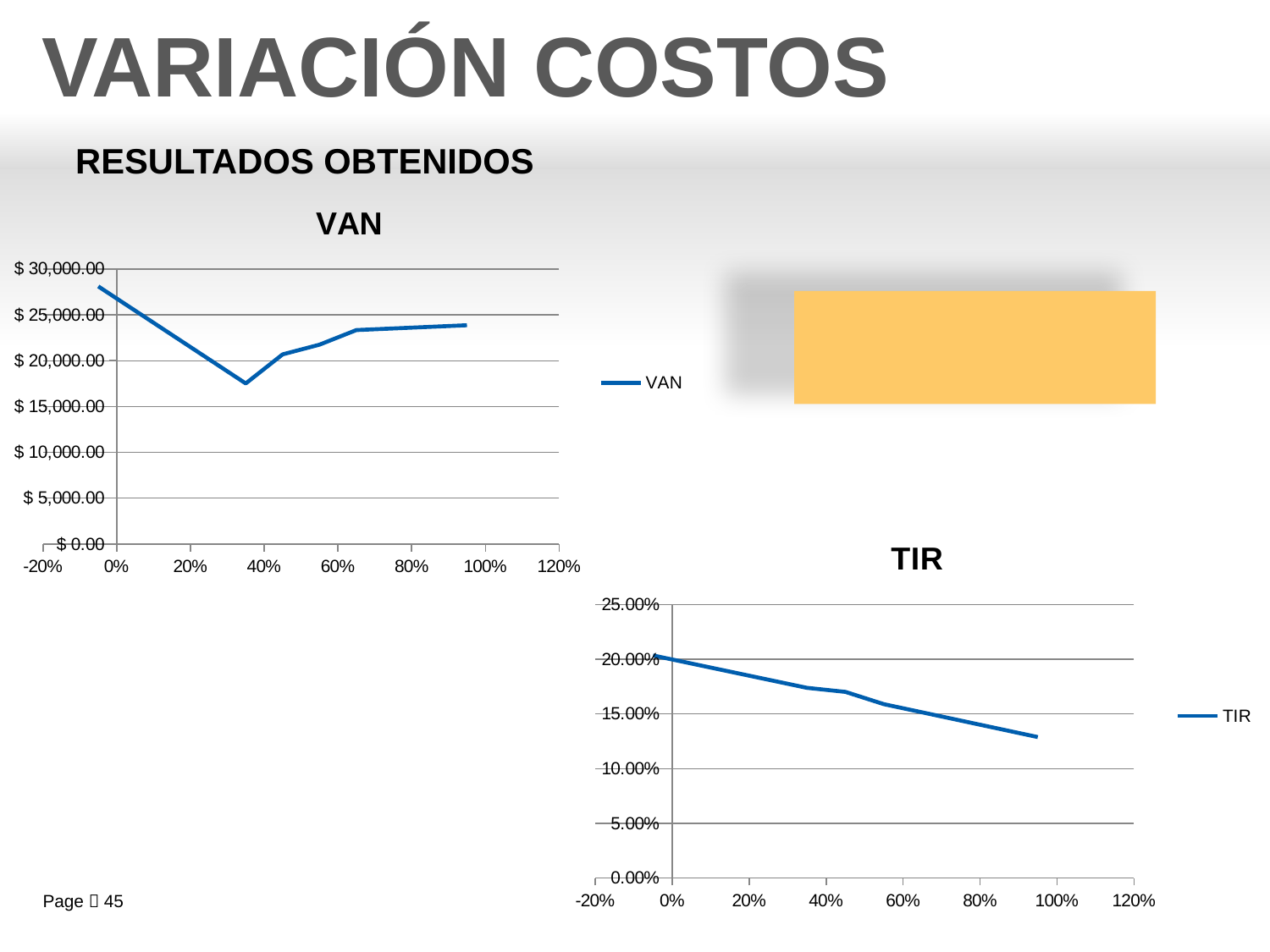
In the TIR chart, is the value at the leftmost point greater or less than 15.00%? greater What kind of chart is the TIR chart? line chart In the VAN chart, is the lowest value on the line greater or less than $20,000.00? less In the TIR chart, is the value at the rightmost point greater or less than 15.00%? less In the VAN chart, is the highest value at the left end or the right end of the line? left end In the TIR chart, do the values rise or fall as the x axis increases? fall What is the title of the chart on the right side of the slide? TIR How many series does the legend of the VAN chart list? 1 In the TIR chart, which is larger, the value at the leftmost point or the value at the rightmost point? leftmost point How many series does the legend of the TIR chart list? 1 What kind of chart is the VAN chart? line chart